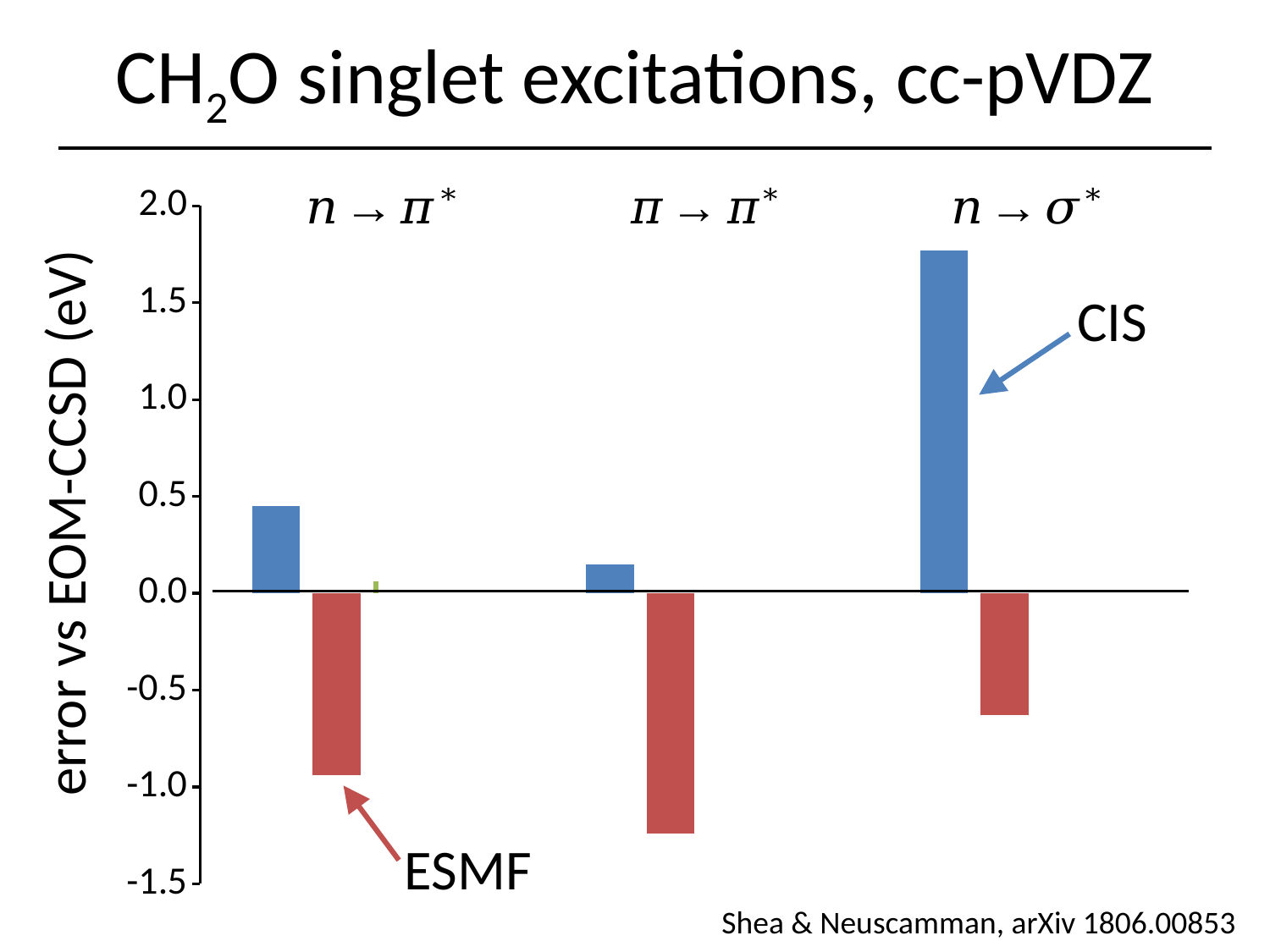
How many excitation categories are shown along the x axis? 3 How many methods are labelled on the chart? 2 Which has the larger CIS error, n → π* or π → π*? n → π* Is the CIS error for n → σ* greater or less than 1.5 eV? greater Is the ESMF error for n → σ* greater or less than -0.5 eV? less What colour are the CIS bars? blue Is the CIS error for n → π* greater or less than 0.5 eV? less What kind of chart is shown on the slide? bar chart For which excitation is the CIS error the largest? n → σ* What is the label of the y axis? error vs EOM-CCSD (eV) For which excitation is the ESMF error the most negative? π → π*